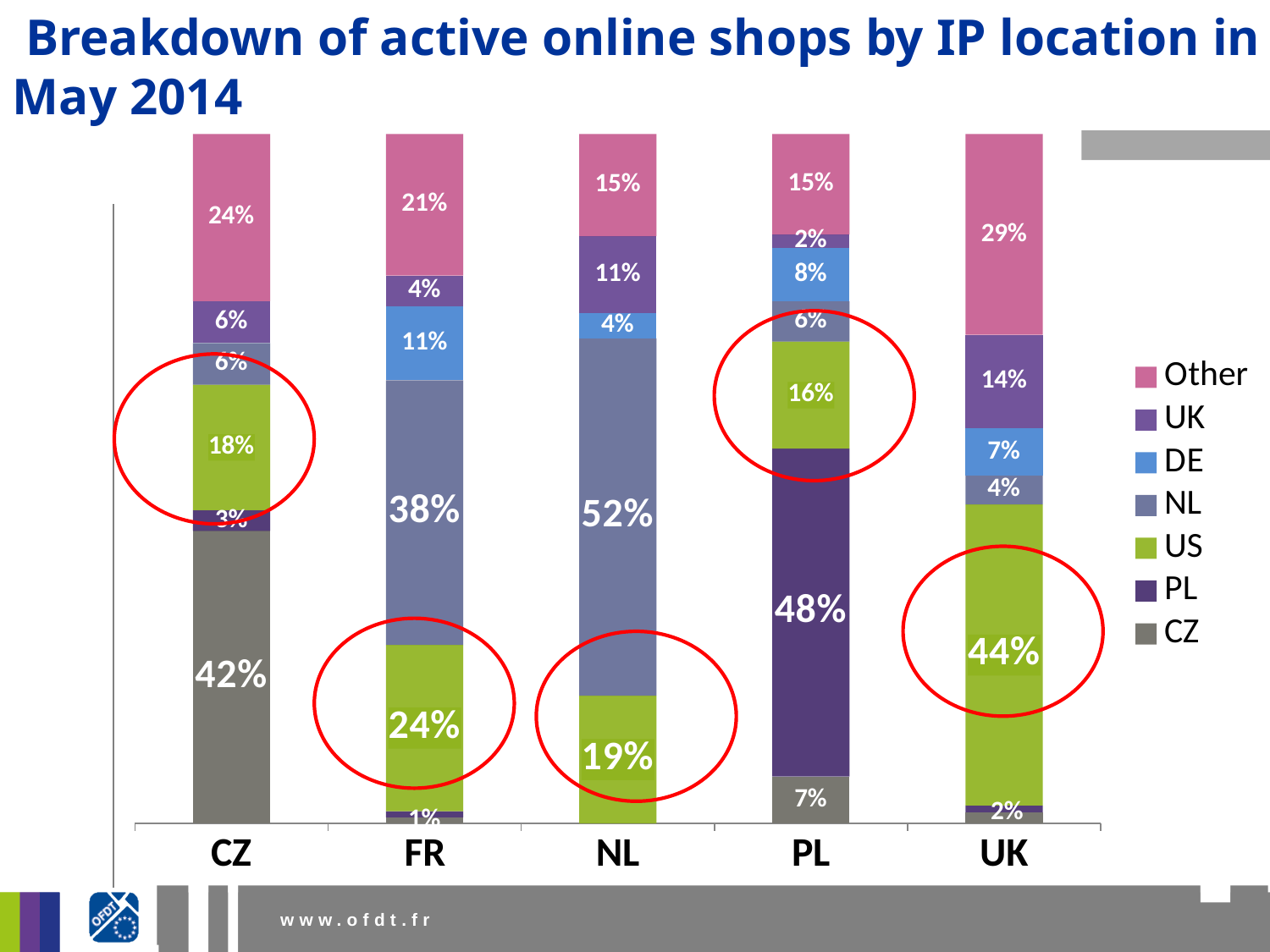
Which country bar has the highest US share? UK How many series does the legend list? 7 What is the CZ share for the CZ bar? 42% What is the PL share for the PL bar? 48% What is the Other share for the FR bar? 21% What is the NL share for the NL bar? 52% Which country bar has the lowest US share? PL What is the US share for the UK bar? 44% What is the difference between the US share in the UK bar and the US share in the FR bar? 20% Which is larger: the Other share in the UK bar or the Other share in the CZ bar? UK bar How many country categories are shown on the x axis? 5 What kind of chart is shown on the slide? Stacked bar chart